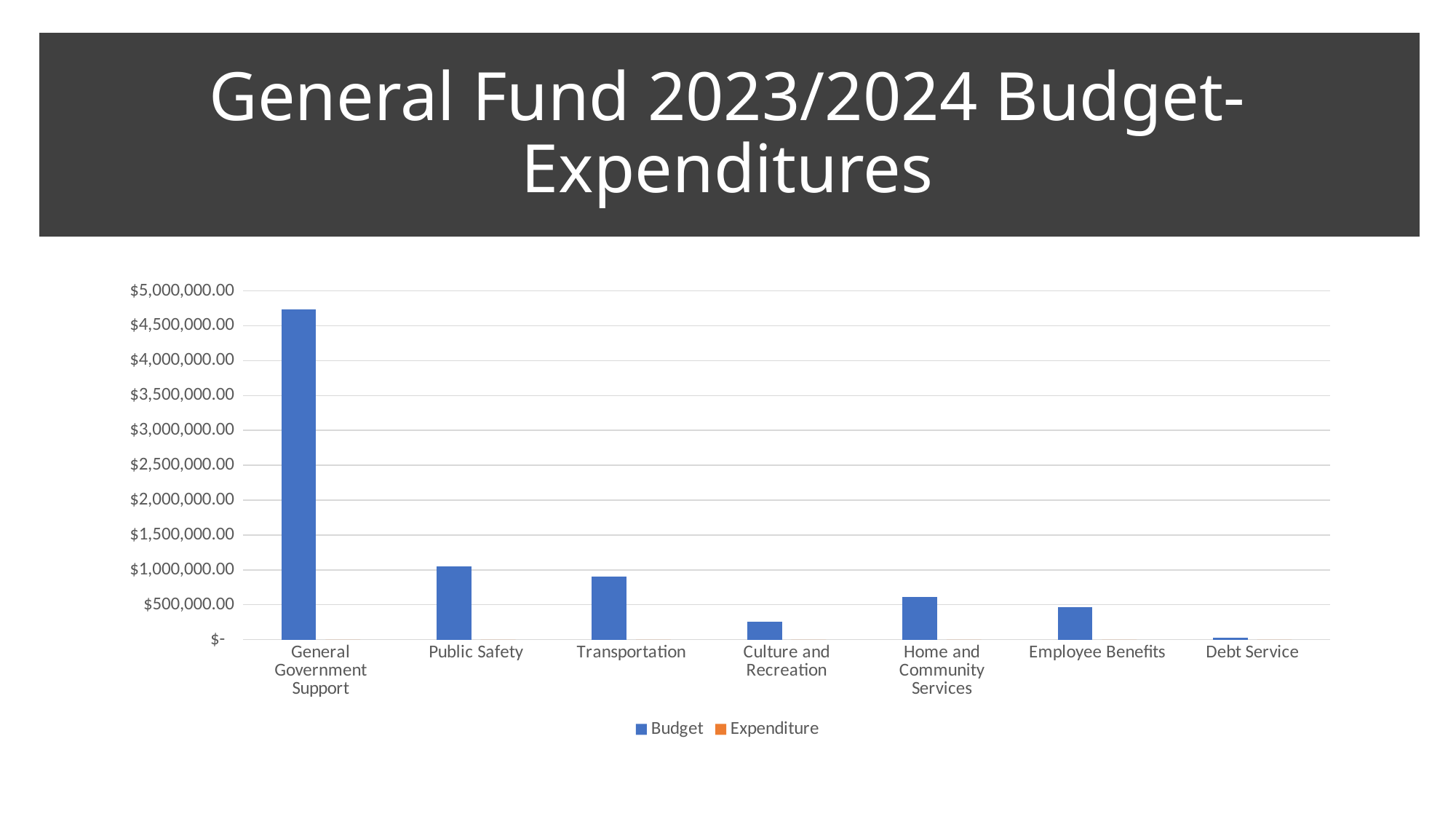
Is the Budget value for General Government Support greater or less than $4,500,000.00? greater How many expenditure categories are shown on the x axis? 7 Is the Budget value for Culture and Recreation greater or less than $500,000.00? less Is the Budget value for Home and Community Services greater or less than $500,000.00? greater Which category has the lowest Budget value? Debt Service How many series does the legend list? 2 Which category has the highest Budget value? General Government Support What kind of chart is shown on the slide? bar chart What is the title of the slide? General Fund 2023/2024 Budget-Expenditures Which has the larger Budget value, Home and Community Services or Employee Benefits? Home and Community Services Which has the larger Budget value, Public Safety or Transportation? Public Safety